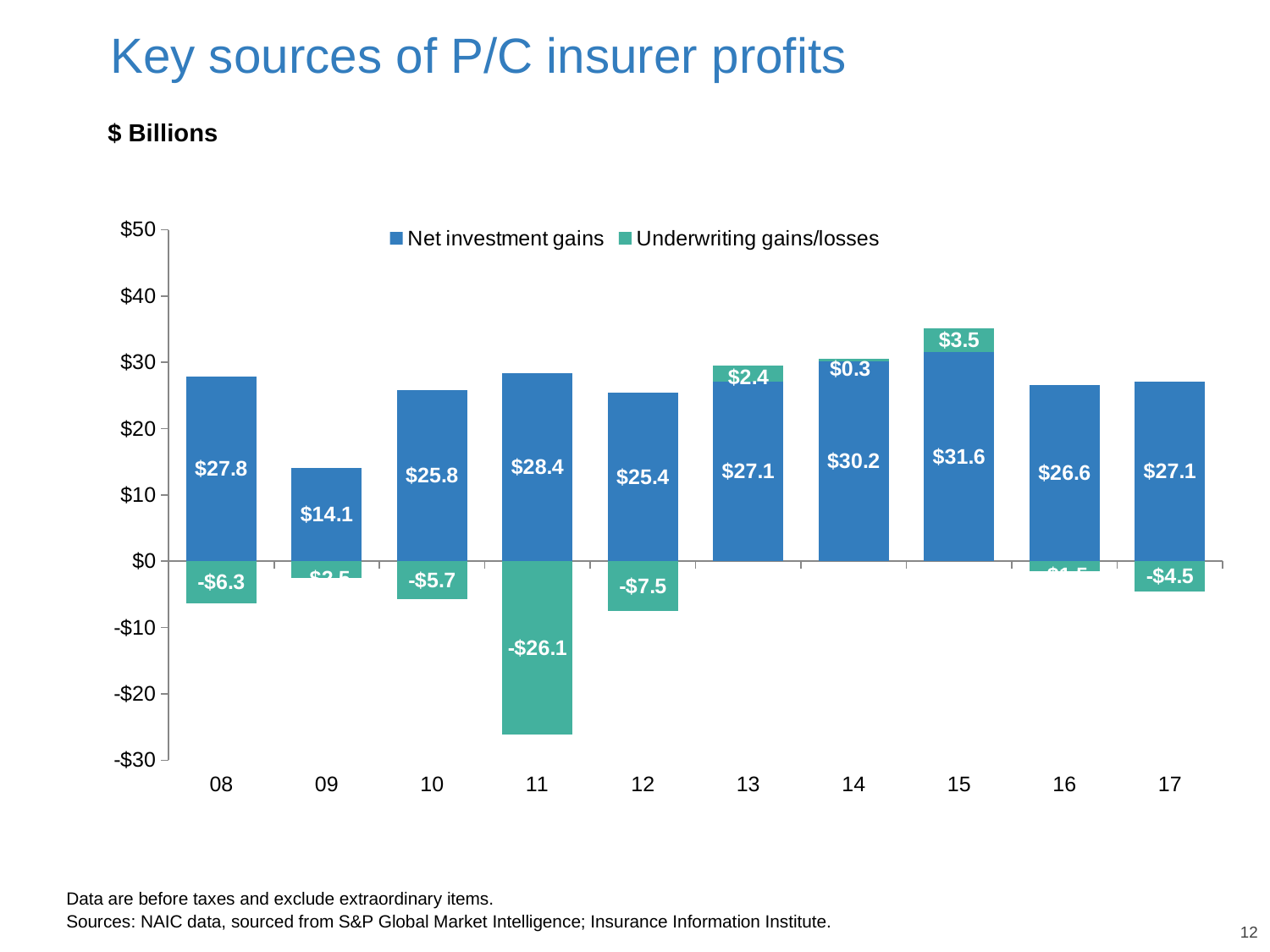
How many years are shown on the x axis? 10 What is the total of the stacked bar for 13 (Net investment gains plus Underwriting gains/losses)? $29.5 Which year has the lowest Underwriting gains/losses value? 11 What is the difference between Net investment gains in 15 and in 09? $17.5 What kind of chart is shown on the slide? Bar chart What is the value of Net investment gains for 09? $14.1 Which year has larger Net investment gains, 14 or 17? 14 Which year has the lowest Net investment gains? 09 Which year has the highest Net investment gains? 15 What is the value of Underwriting gains/losses for 11? -$26.1 How many series does the legend list? 2 What is the value of Net investment gains for 15? $31.6